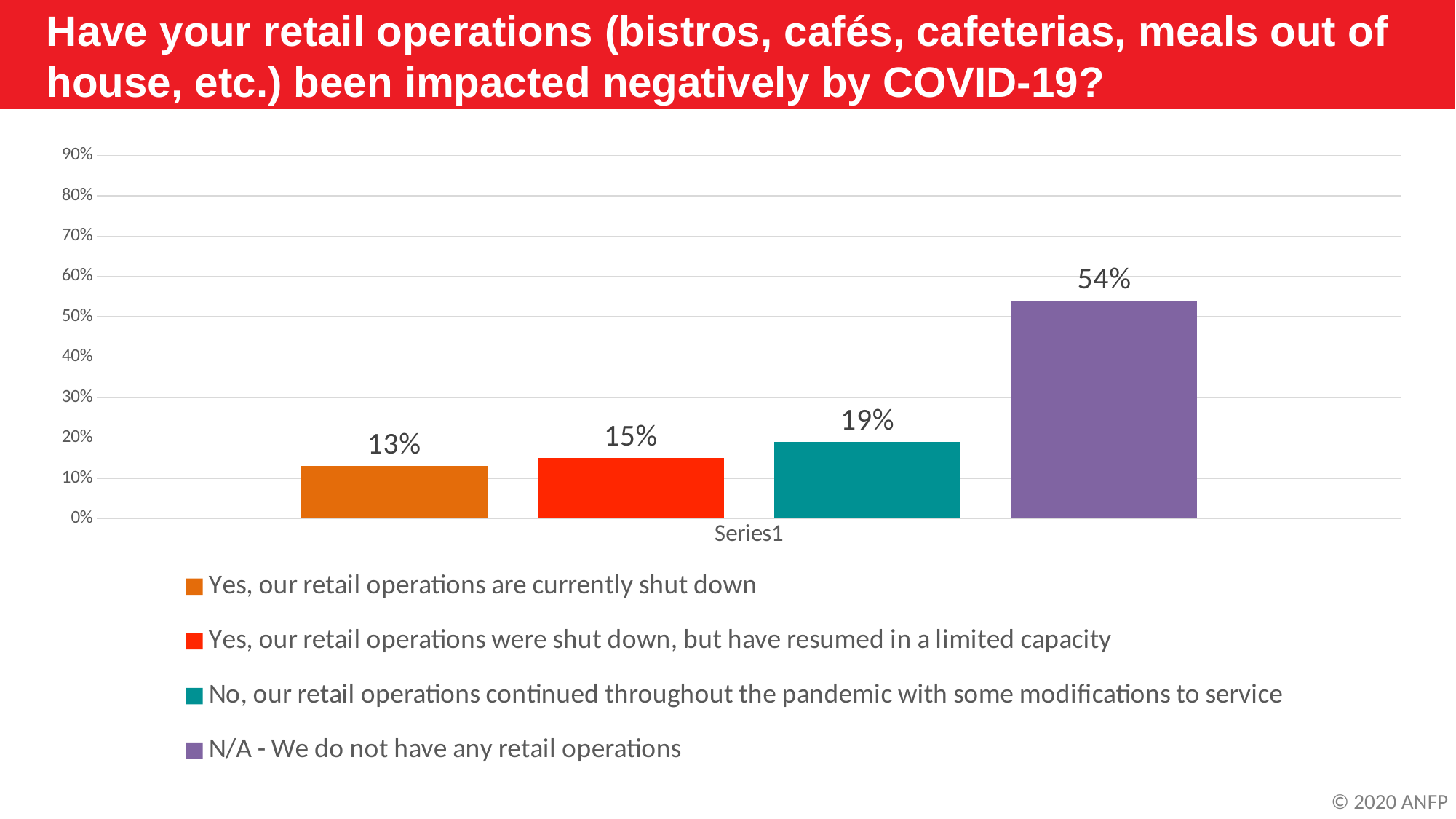
What is the difference in percentage points between 'N/A - We do not have any retail operations' and 'No, our retail operations continued throughout the pandemic with some modifications to service'? 35 percentage points What percentage of respondents said their retail operations continued throughout the pandemic with some modifications to service? 19% Is the value for 'N/A - We do not have any retail operations' greater or less than 50%? greater Which is larger: the percentage for 'Yes, our retail operations were shut down, but have resumed in a limited capacity' or for 'Yes, our retail operations are currently shut down'? Yes, our retail operations were shut down, but have resumed in a limited capacity Which response option has the lowest percentage? Yes, our retail operations are currently shut down What kind of chart is shown on the slide? Bar chart What percentage of respondents said they do not have any retail operations? 54% Which response option has the highest percentage? N/A - We do not have any retail operations How many response options are plotted in the chart? 4 What colour is the bar for 'N/A - We do not have any retail operations'? Purple What percentage of respondents said their retail operations are currently shut down? 13% What percentage of respondents said their retail operations were shut down but have resumed in a limited capacity? 15%